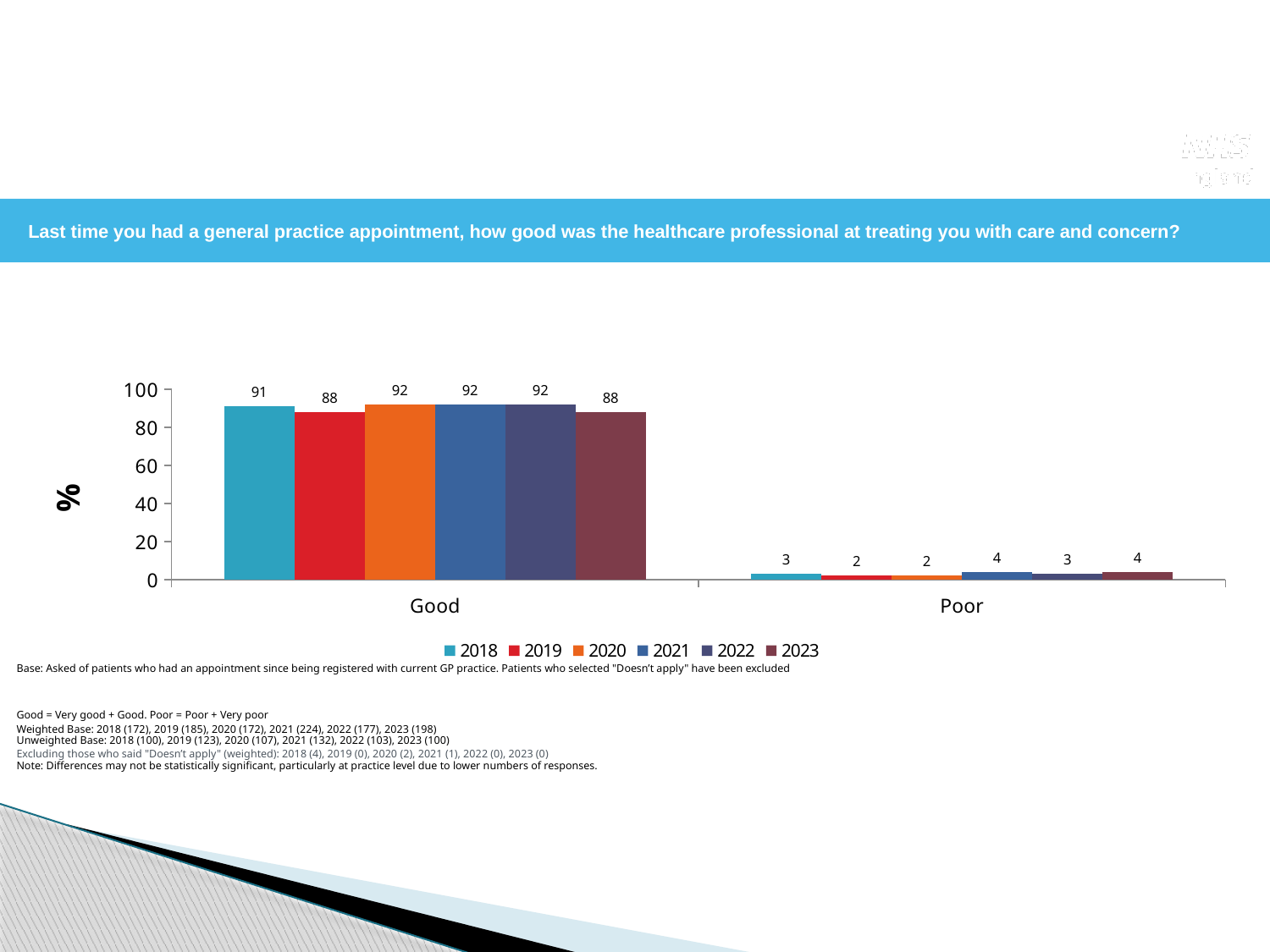
What is the difference between the 2021 and 2022 values in the Poor category? 1 What is the value for 2019 in the Good category? 88 Which year has the lowest value in the Poor category? 2019 and 2020 How many categories are shown on the x axis? 2 Which is larger in the Good category, the value for 2018 or the value for 2019? 2018 What kind of chart is shown on the slide? bar chart What is the value for 2023 in the Poor category? 4 Is the value for 2022 in the Good category greater or less than 80? greater What is the difference between the 2020 and 2023 values in the Good category? 4 What is the label on the y axis? % How many series does the legend list? 6 What is the value for 2018 in the Good category? 91